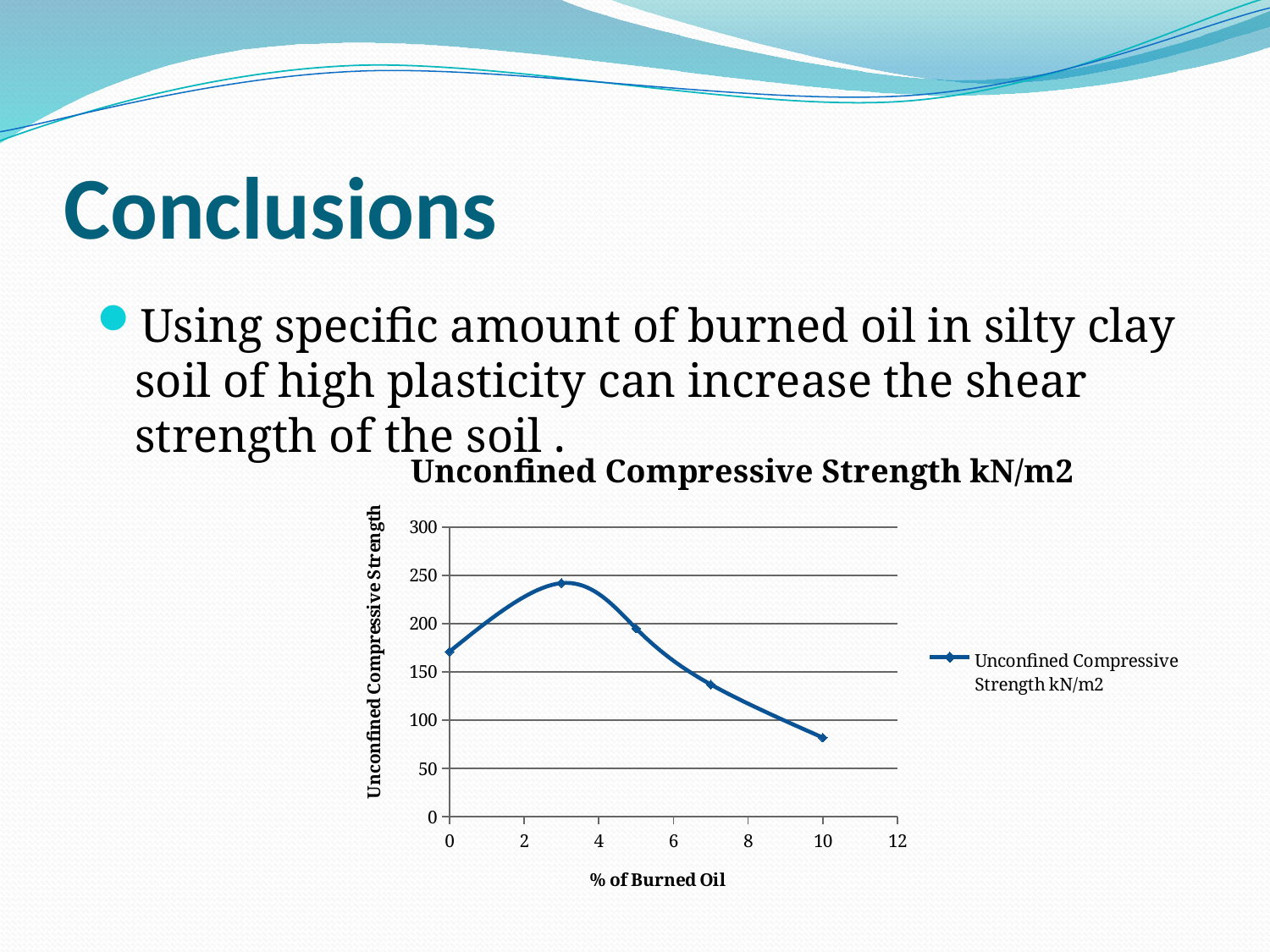
Is the unconfined compressive strength at 0% burned oil greater or less than 150? greater Does the unconfined compressive strength rise or fall between 3% and 10% burned oil? fall How many series does the legend list? 1 Is the unconfined compressive strength at 10% burned oil greater or less than 100? less At which % of burned oil is the unconfined compressive strength lowest? 10 Is the unconfined compressive strength at 3% burned oil greater or less than 200? greater At which % of burned oil is the unconfined compressive strength highest? 3 Which has a higher unconfined compressive strength: 5% burned oil or 7% burned oil? 5% burned oil How many data points are plotted on the line? 5 What is the label of the x axis of the chart? % of Burned Oil What kind of chart is shown on the slide? line chart What is the title of the chart? Unconfined Compressive Strength kN/m2